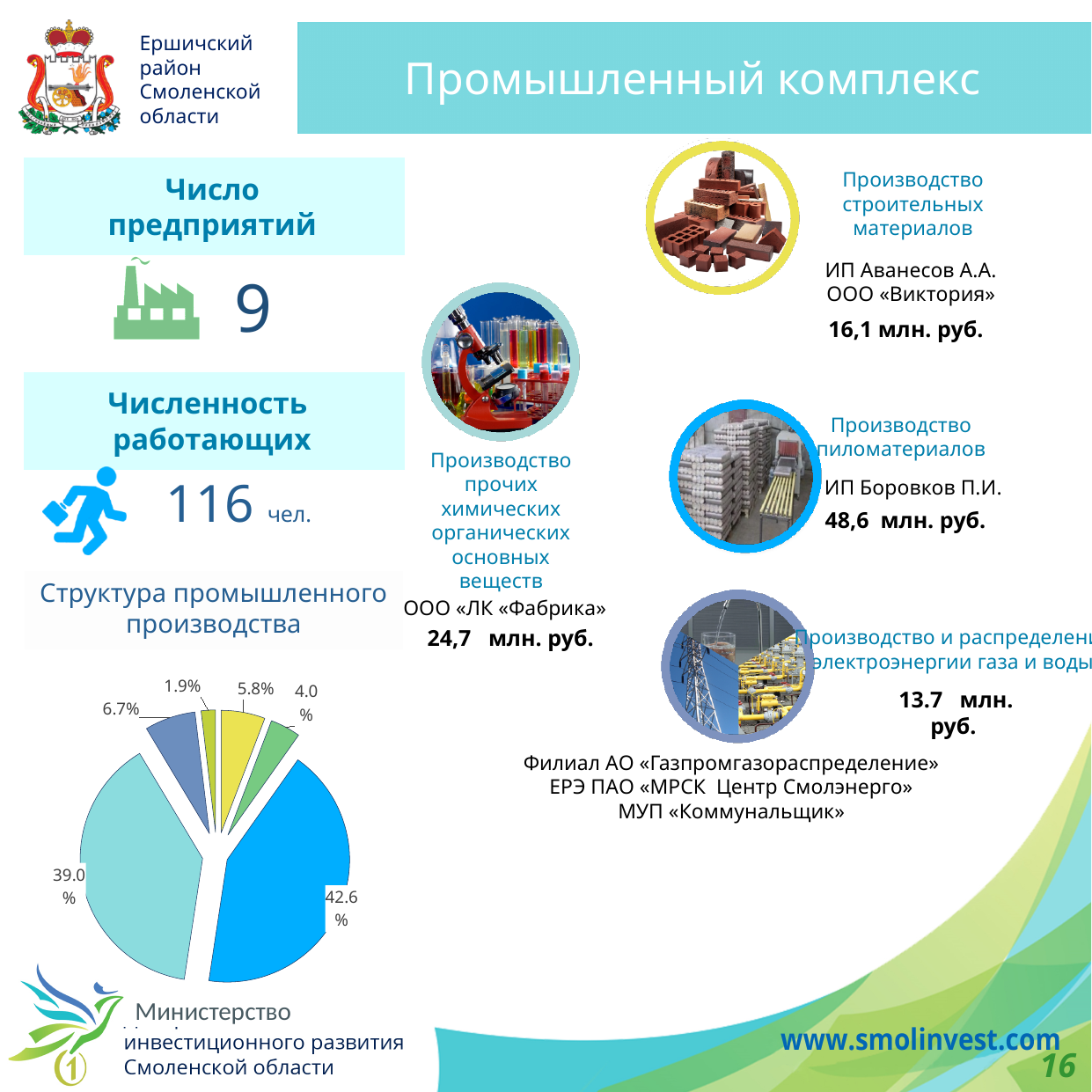
In the pie chart "Структура промышленного производства", which slice is larger: the slate-blue slice (6.7%) or the yellow slice (5.8%)? The slate-blue slice (6.7%) What is the title of the pie chart on the slide? Структура промышленного производства In the pie chart "Структура промышленного производства", what is the difference between the two largest slices (42.6% and 39.0%)? 3.6 percentage points How many slices does the pie chart "Структура промышленного производства" have? 6 What kind of chart is shown under the heading "Структура промышленного производства"? Pie chart What is the value of the yellow slice in the pie chart "Структура промышленного производства"? 5.8% What is the value of the smallest slice in the pie chart "Структура промышленного производства"? 1.9% What is the value of the green slice in the pie chart "Структура промышленного производства"? 4.0% What is the value of the light cyan slice in the pie chart "Структура промышленного производства"? 39.0% What is the value of the largest slice in the pie chart "Структура промышленного производства"? 42.6% Does the pie chart "Структура промышленного производства" have a legend? No In the pie chart "Структура промышленного производства", what do the two largest slices (42.6% and 39.0%) add up to? 81.6%